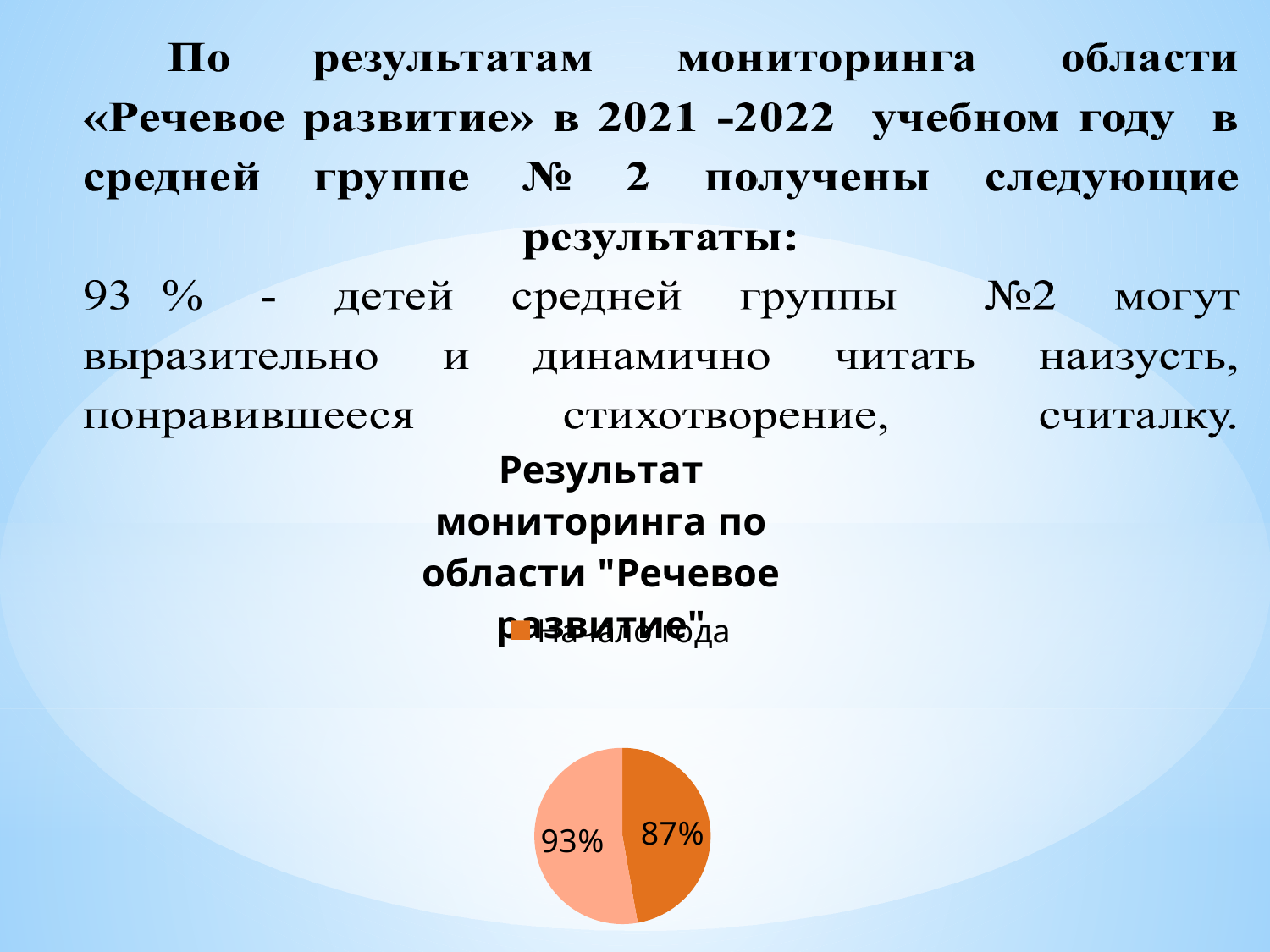
What value is labelled on the light orange slice of the pie chart? 93% Which slice of the pie chart has the lowest value? 87% What value is labelled on the dark orange slice of the pie chart? 87% How many slices does the pie chart have? 2 What is the value for "Начало года" in the pie chart? 87% What kind of chart is shown on the slide? pie chart What is the difference between the two values labelled on the pie chart? 6% Which legend entry is readable on the chart? Начало года Which slice of the pie chart has the highest value? 93% Which is larger: the dark orange slice or the light orange slice? the light orange slice What is the title of the chart? Результат мониторинга по области "Речевое развитие"